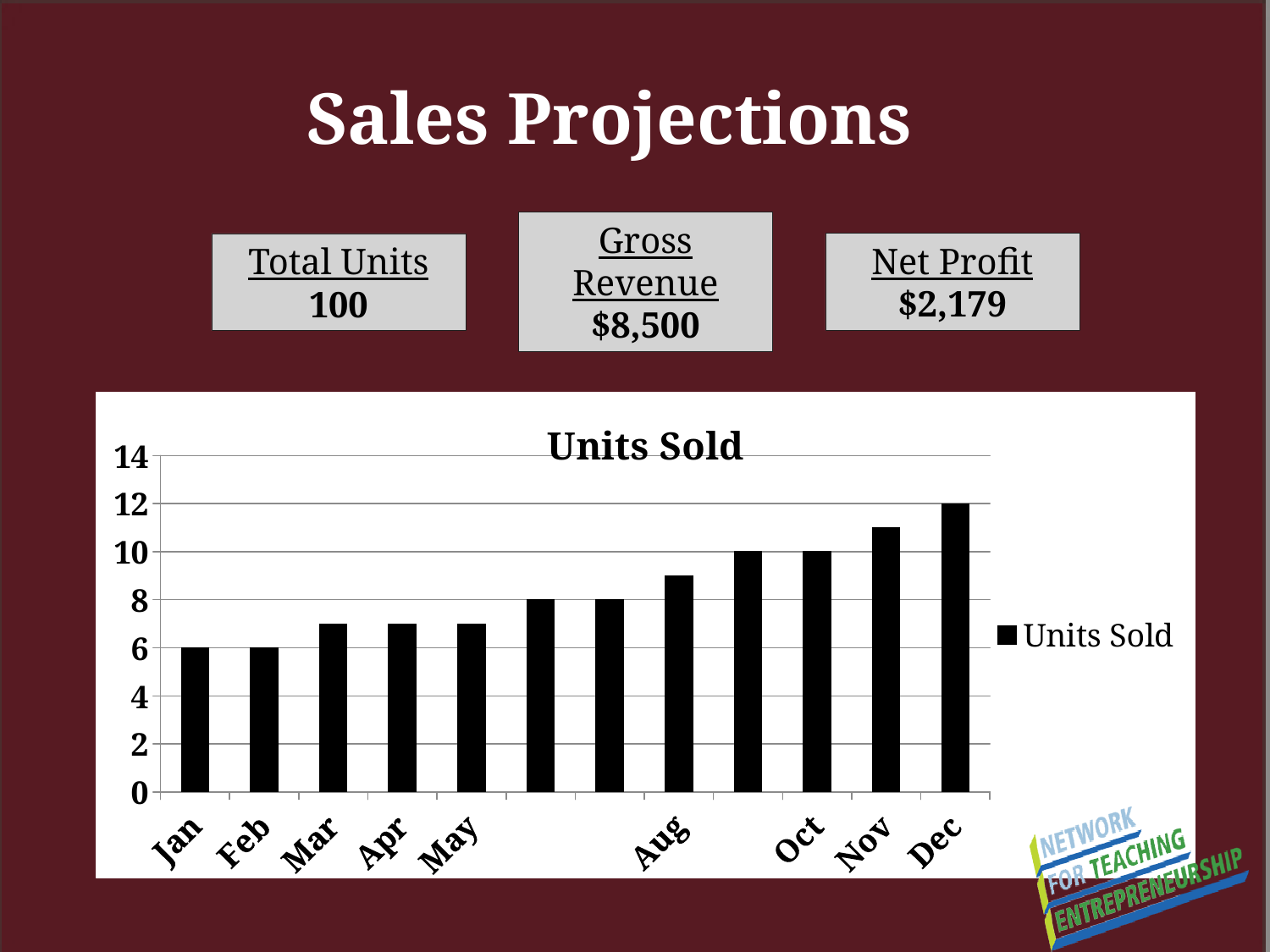
How many bars are plotted in the Units Sold chart? 12 Do the values in the Units Sold chart generally rise or fall from Jan to Dec? Rise What is the difference between the values for Dec and Jan in the Units Sold chart? 6 Which is larger in the Units Sold chart, the value for Oct or the value for Feb? Oct Which month has the highest value in the Units Sold chart? Dec What is the value for Oct in the Units Sold chart? 10 Is the value for Mar in the Units Sold chart greater or less than 8? less Is the value for Nov in the Units Sold chart greater or less than 10? greater What is the value for Dec in the Units Sold chart? 12 How many series does the legend of the Units Sold chart list? 1 What kind of chart is shown on the slide? Bar chart What is the value for Jan in the Units Sold chart? 6